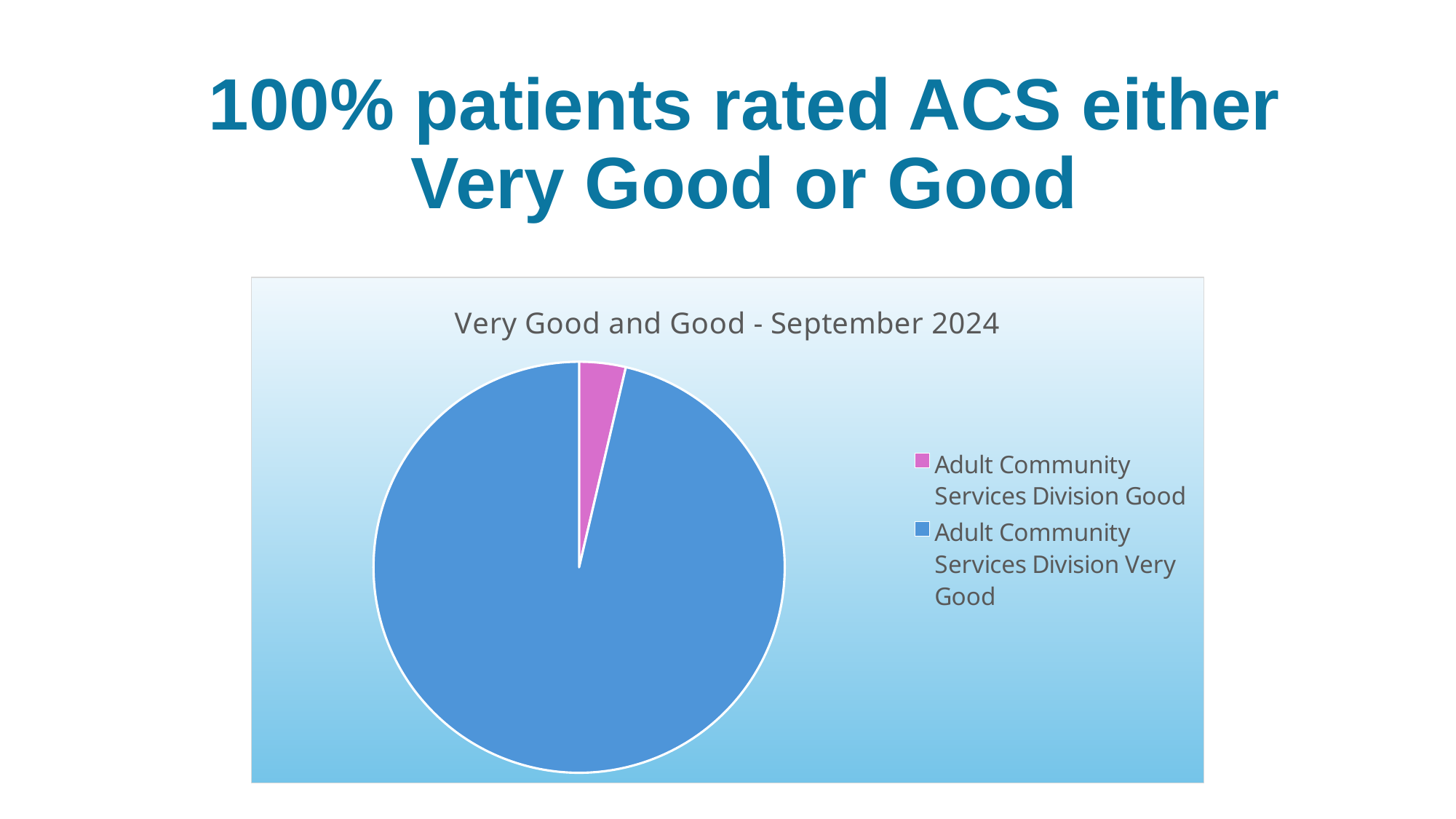
What colour is the Adult Community Services Division Good slice? pink Which slice of the pie chart is the largest? Adult Community Services Division Very Good How many entries does the chart legend list? 2 Which slice of the pie chart is the smallest? Adult Community Services Division Good What kind of chart is shown on the slide? pie chart How many slices does the pie chart have? 2 What is the title of the chart? Very Good and Good - September 2024 Which is larger: the Adult Community Services Division Good slice or the Adult Community Services Division Very Good slice? Adult Community Services Division Very Good